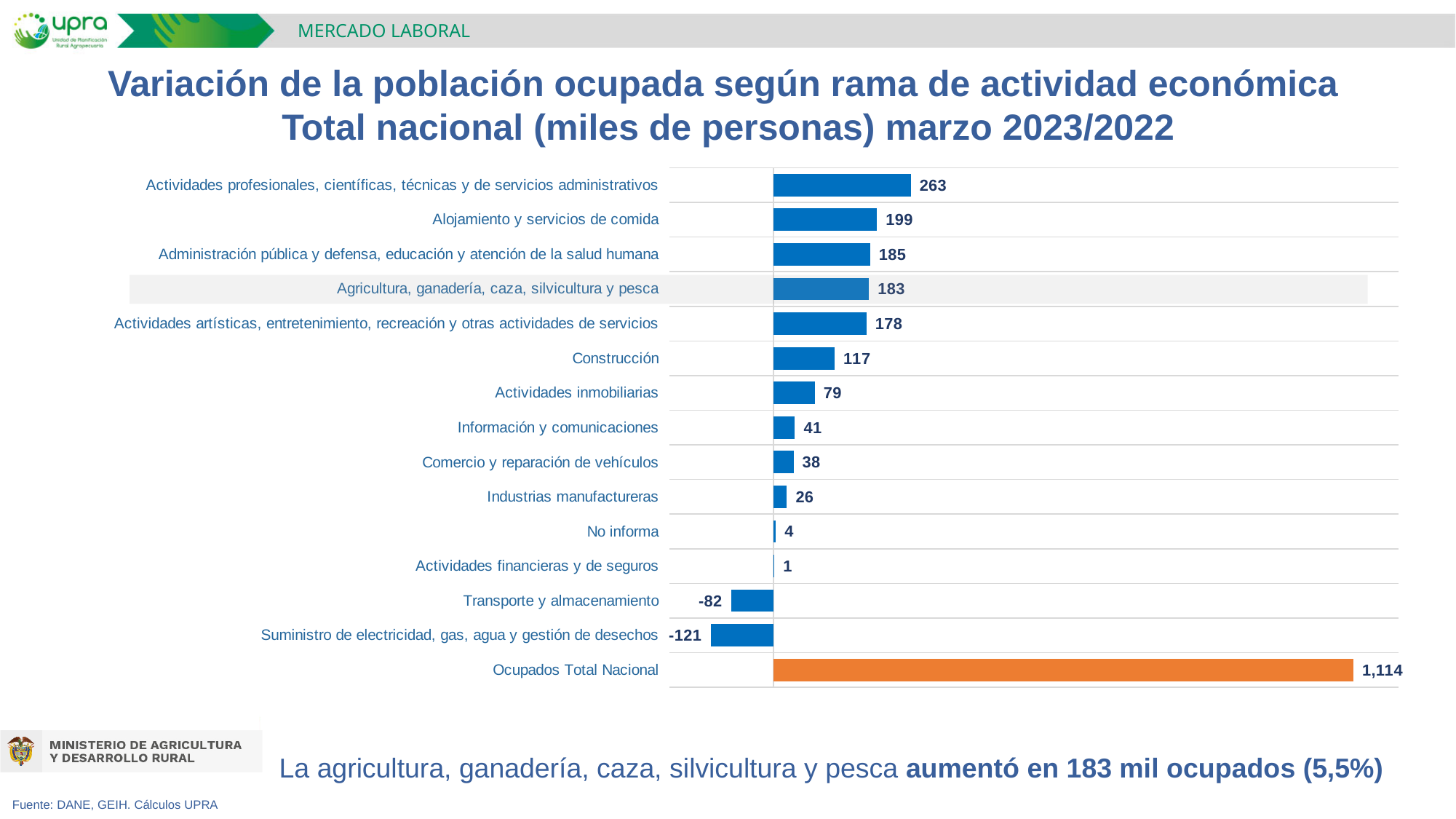
What kind of chart is shown on the slide? Bar chart What is the difference between the values for Actividades profesionales, científicas, técnicas y de servicios administrativos and Alojamiento y servicios de comida? 64 How many categories are shown in the chart? 15 Which category has the lowest value? Suministro de electricidad, gas, agua y gestión de desechos What is the value for Agricultura, ganadería, caza, silvicultura y pesca? 183 What is the value for Transporte y almacenamiento? -82 What is the value for Construcción? 117 Excluding Ocupados Total Nacional, which category has the highest value? Actividades profesionales, científicas, técnicas y de servicios administrativos What is the difference between the values for Agricultura, ganadería, caza, silvicultura y pesca and Construcción? 66 What is the value for Ocupados Total Nacional? 1,114 Which is larger, the value for Actividades inmobiliarias or the value for Información y comunicaciones? Actividades inmobiliarias What colour is the bar for Ocupados Total Nacional? Orange